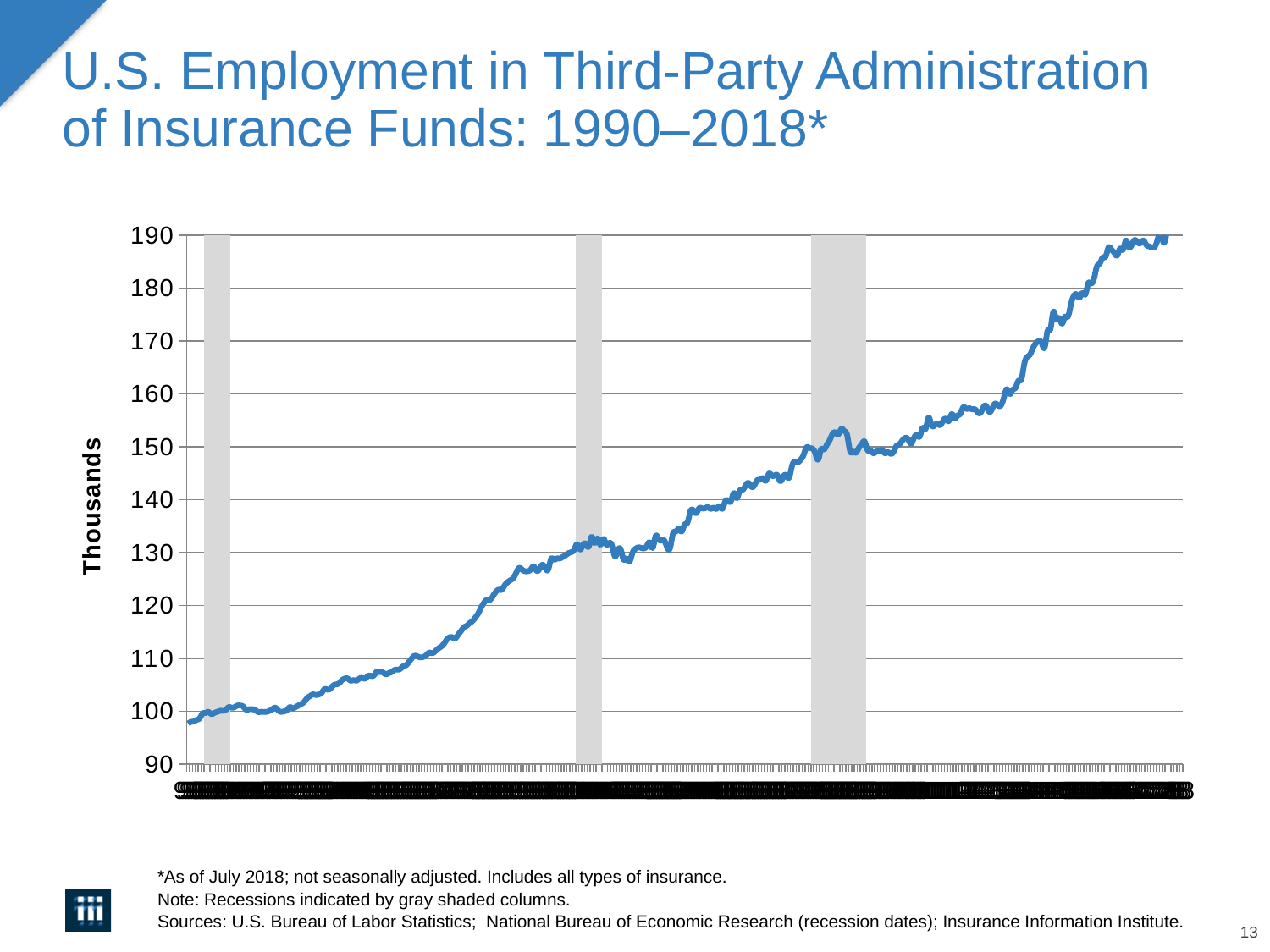
Is the value during the second gray shaded recession column greater or less than 120? greater What kind of chart is shown on the slide? line chart What is the highest value shown on the y axis? 190 What is the label on the y axis? Thousands Is the value at the start of the series (1990) greater or less than 110? less Is the value at the end of the series (2018) greater or less than 180? greater Do the values generally rise or fall from 1990 to 2018? rise